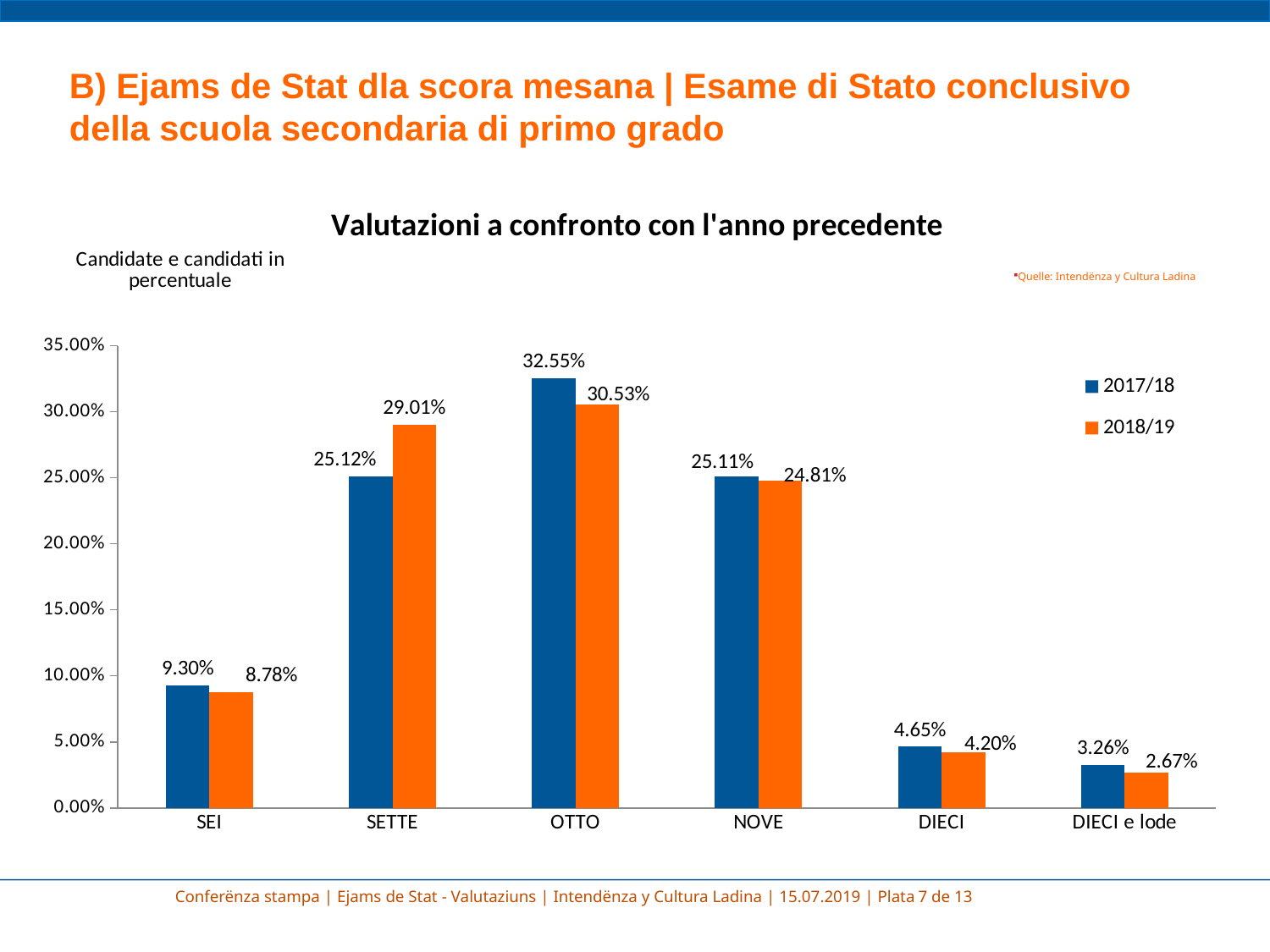
How many categories are shown on the x axis? 6 What is the value for DIECI e lode in the 2018/19 series? 2.67% What is the value for SETTE in the 2018/19 series? 29.01% What kind of chart is shown on the slide? bar chart What is the difference between the 2017/18 and 2018/19 values for OTTO? 2.02% How many series does the legend list? 2 Is the 2017/18 value for NOVE greater or less than 20.00%? greater Which category has the highest value in the 2017/18 series? OTTO What is the title of the chart? Valutazioni a confronto con l'anno precedente Which is larger for SETTE: the 2017/18 value or the 2018/19 value? 2018/19 What is the value for DIECI in the 2017/18 series? 4.65% Which category has the lowest value in the 2018/19 series? DIECI e lode